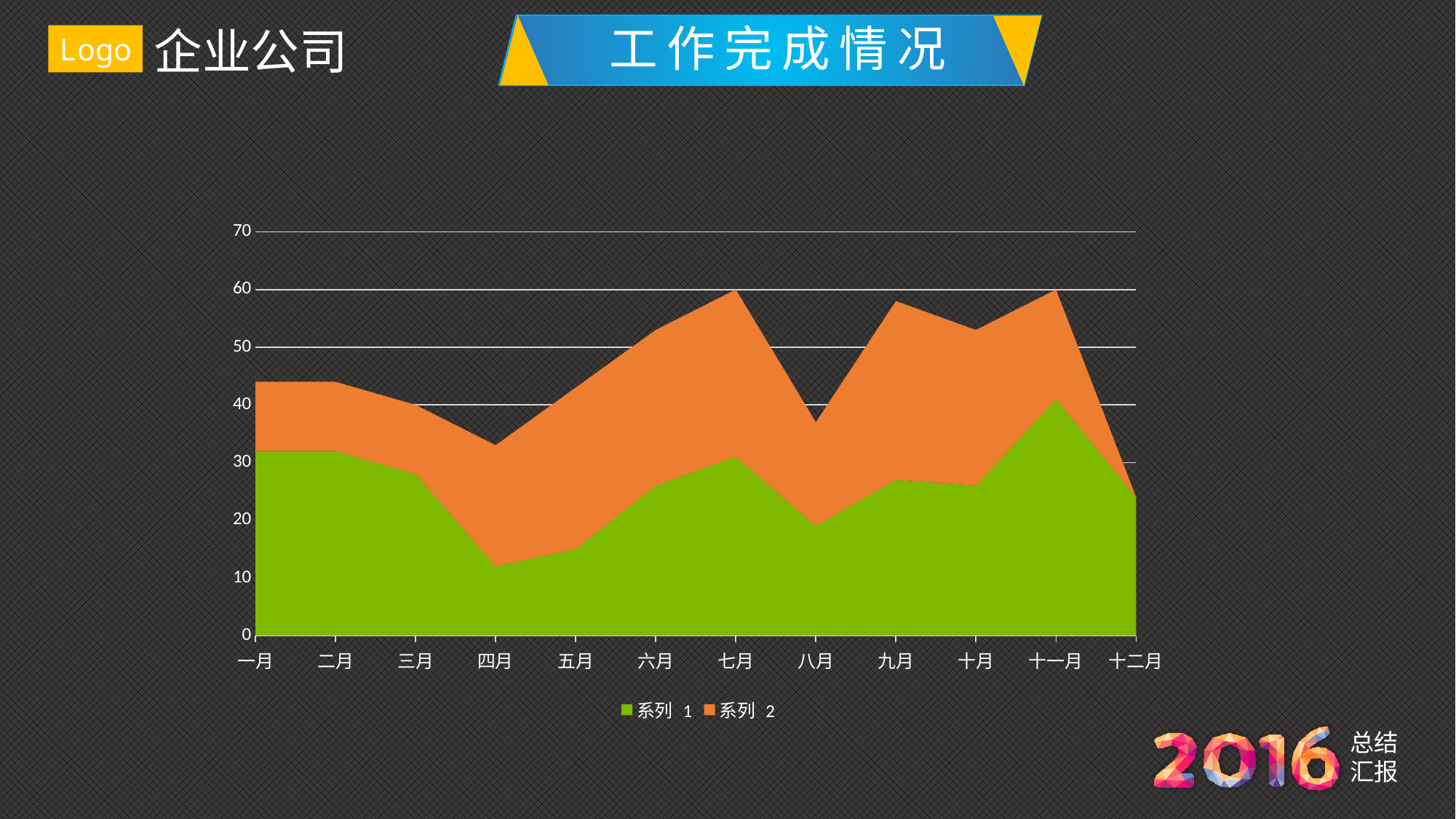
What kind of chart is shown on the slide? Area chart In which month does 系列 1 reach its lowest value? 四月 Is the value for 系列 1 in 四月 greater or less than 20? less Which is larger for 系列 1: the value in 一月 or the value in 四月? 一月 Is the stacked total for 十二月 greater or less than 30? less What colour represents 系列 2 in the chart? Orange How many months are shown along the x axis of the chart? 12 Does the value of 系列 1 rise or fall from 三月 to 四月? Fall In which month does 系列 1 reach its highest value? 十一月 Is the value for 系列 1 in 十一月 greater or less than 30? greater How many series does the chart's legend list? 2 What is the title of the slide containing the chart? 工作完成情况